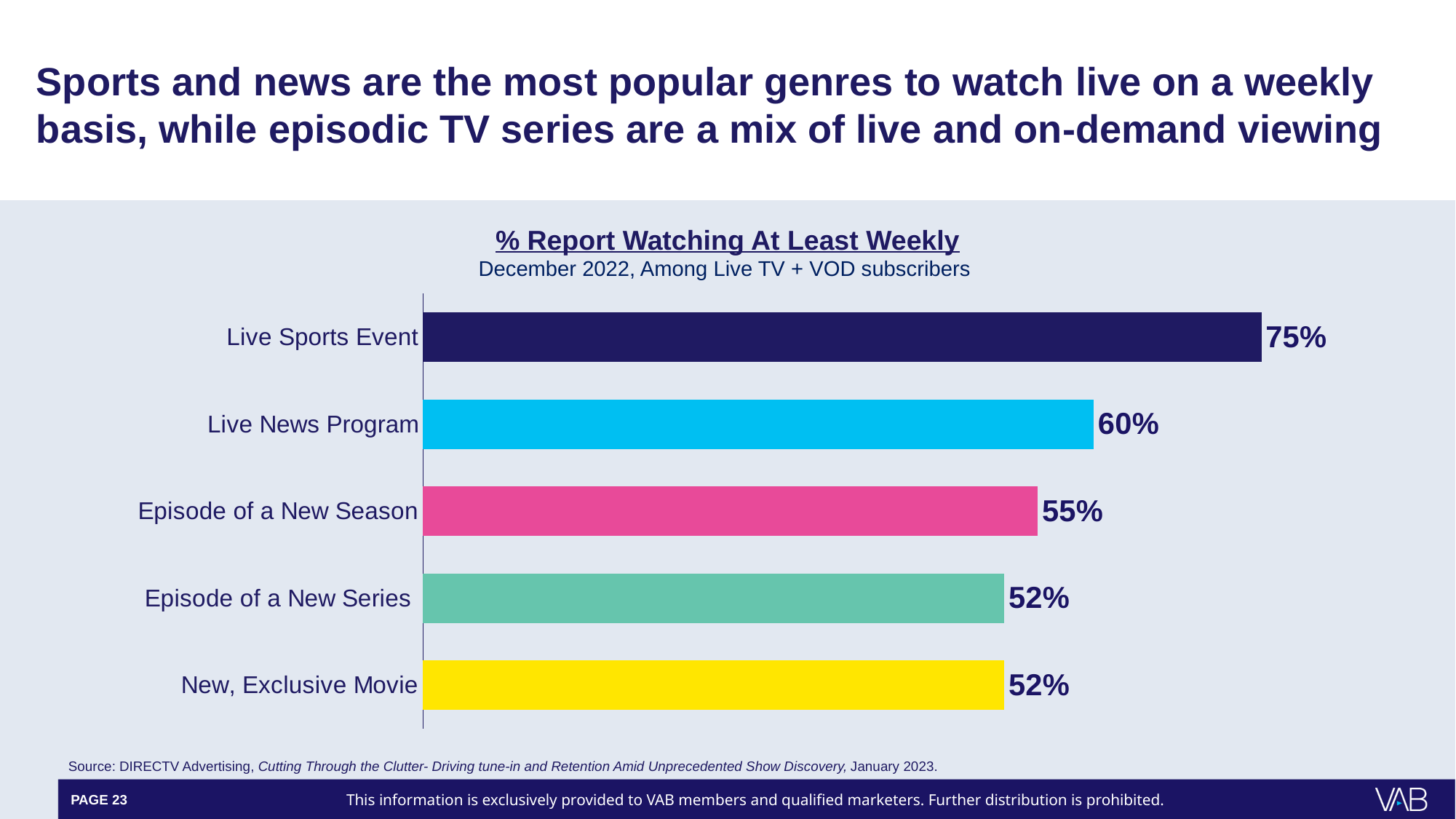
What is the difference between Live Sports Event and Live News Program? 15% Which category has the highest percentage? Live Sports Event How many categories are shown in the chart? 5 What is the value for New, Exclusive Movie? 52% What percentage report watching an Episode of a New Season at least weekly? 55% What kind of chart is shown on the slide? Bar chart Which is larger, Episode of a New Season or Episode of a New Series? Episode of a New Season What is the value for Live News Program? 60% What colour is the bar for Live News Program? Light blue What percentage report watching a Live Sports Event at least weekly? 75% What is the difference between Live News Program and Episode of a New Season? 5% What is the title of the chart? % Report Watching At Least Weekly